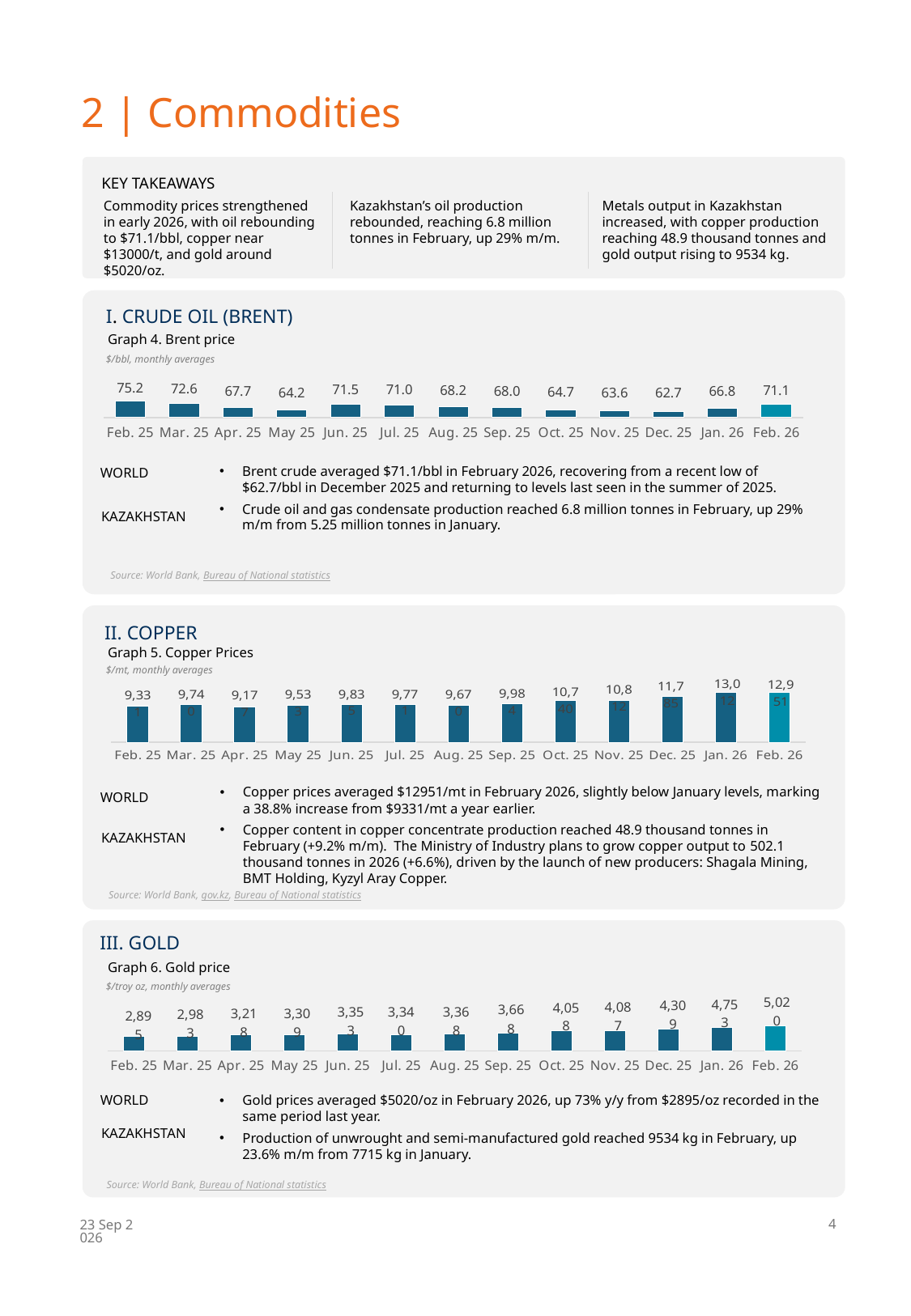
In Graph 5 (Copper Prices), which month has the highest copper price? Jan. 26 In Graph 4 (Brent price), how many months are plotted? 13 In Graph 4 (Brent price), which is larger, the value for Jun. 25 or the value for Jul. 25? Jun. 25 In Graph 4 (Brent price), what was the Brent price in Feb. 26? 71.1 In Graph 6 (Gold price), do the values generally rise or fall from Feb. 25 to Feb. 26? Rise What type of chart is Graph 5 (Copper Prices)? Bar chart In Graph 4 (Brent price), what was the Brent price in Dec. 25? 62.7 In Graph 4 (Brent price), which month has the highest Brent price? Feb. 25 In Graph 4 (Brent price), what is the difference between the Feb. 25 value and the Dec. 25 value? 12.5 In Graph 4 (Brent price), which month has the lowest Brent price? Dec. 25 In Graph 6 (Gold price), which month has the highest gold price? Feb. 26 In Graph 6 (Gold price), which month has the lowest gold price? Feb. 25